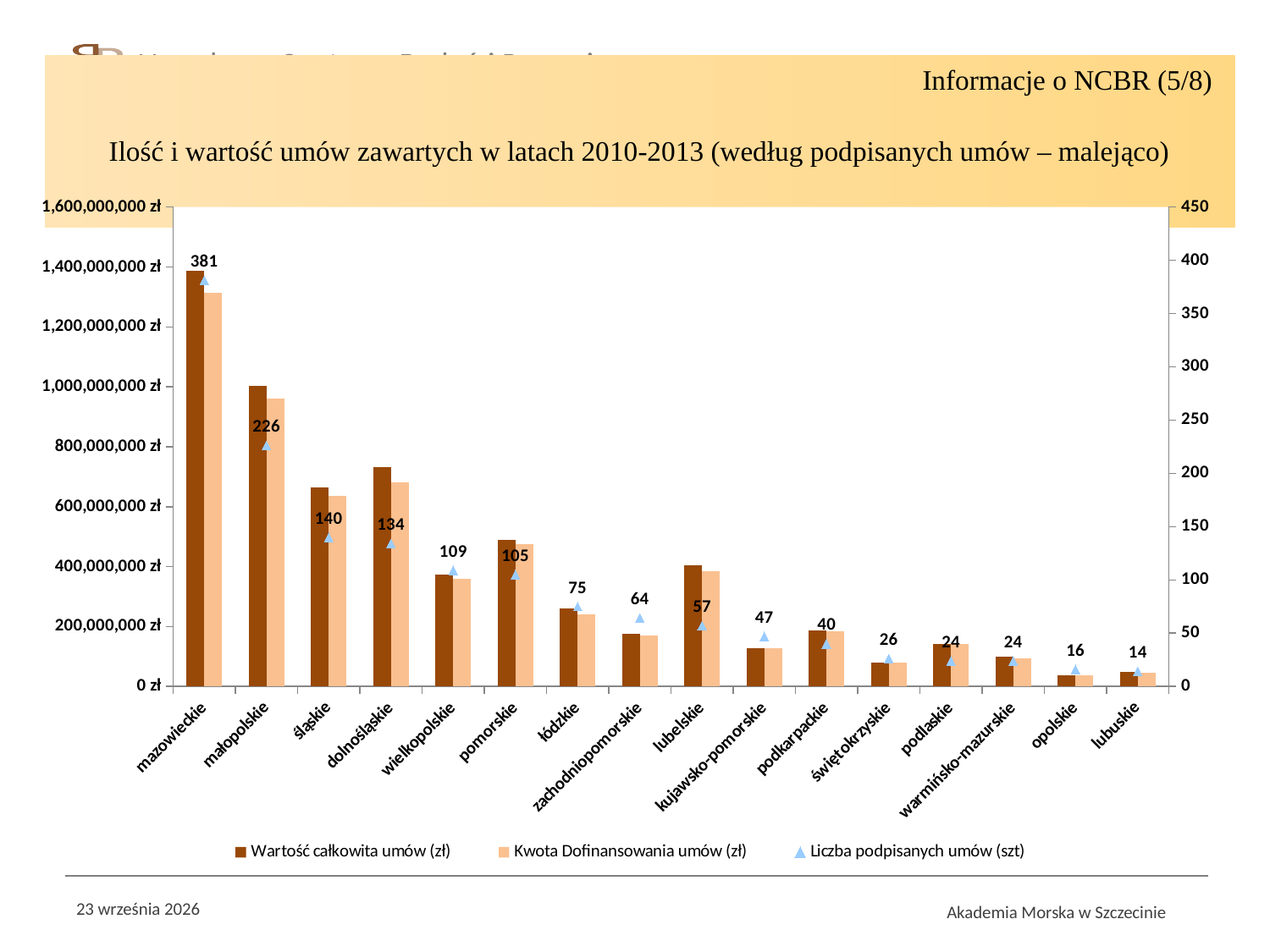
Is the Wartość całkowita umów (zł) for dolnośląskie greater or less than 600,000,000 zł? greater Which has more signed contracts, śląskie or dolnośląskie? śląskie Is the Wartość całkowita umów (zł) for mazowieckie greater or less than 1,200,000,000 zł? greater What is the number of signed contracts for łódzkie? 75 What is the number of signed contracts for podkarpackie? 40 How many voivodeships are shown on the x axis? 16 Which voivodeship has the lowest number of signed contracts? lubuskie Does the number of signed contracts rise or fall from left to right along the x axis? fall How many series does the legend list? 3 What is the difference in the number of signed contracts between mazowieckie and małopolskie? 155 How many signed contracts (Liczba podpisanych umów) are shown for mazowieckie? 381 Which voivodeship has the highest number of signed contracts? mazowieckie